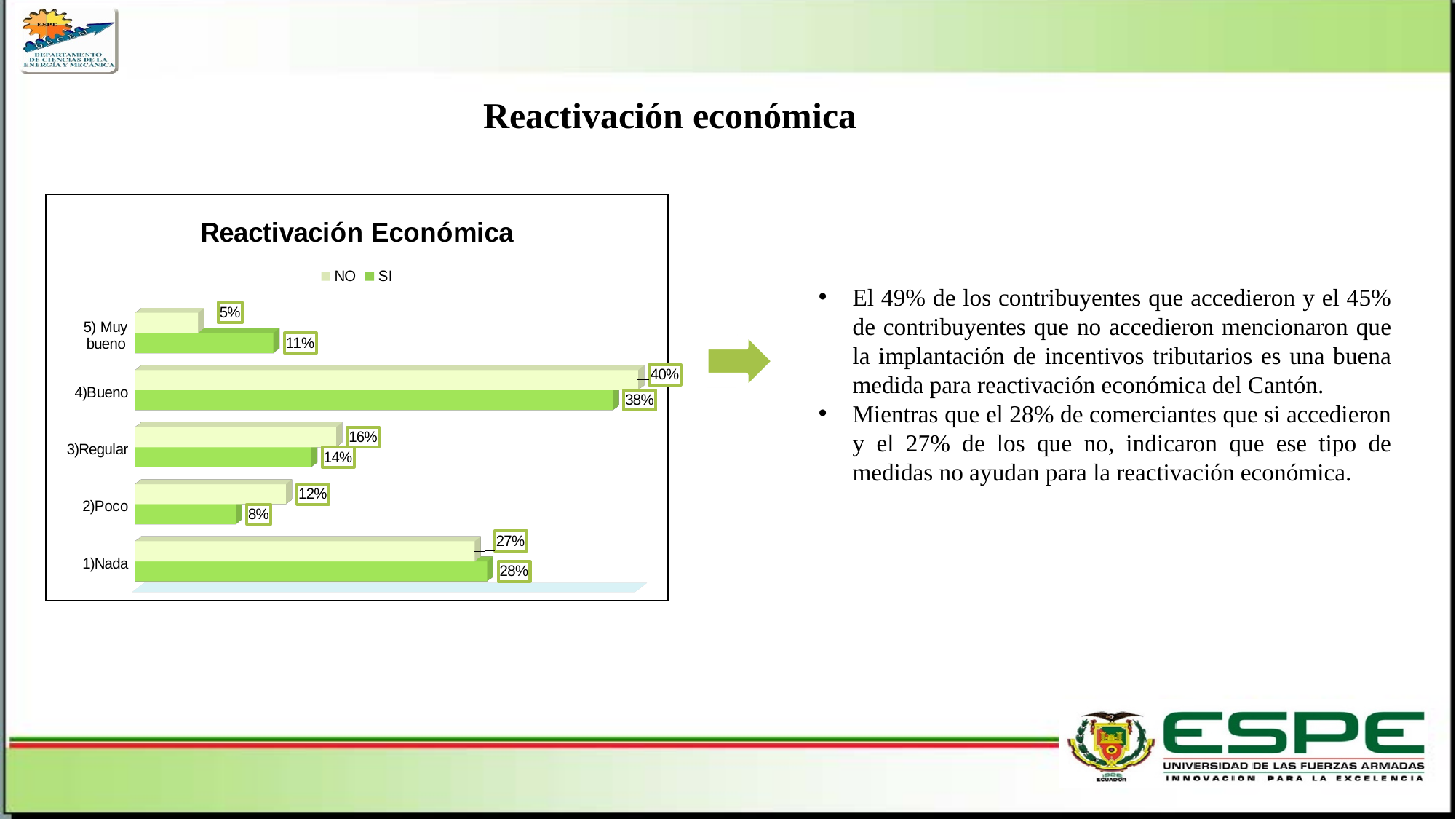
How many categories are shown in the chart? 5 What is the value of the NO series for the category 4)Bueno? 40% How many series does the legend list? 2 Which category has the highest value in the SI series? 4)Bueno What is the value of the SI series for the category 1)Nada? 28% What is the value of the NO series for the category 2)Poco? 12% What is the title of the chart? Reactivación Económica What kind of chart is shown on the slide? Bar chart What is the value of the SI series for the category 5) Muy bueno? 11% What is the difference between the NO and SI values for the category 3)Regular? 2% For the category 2)Poco, which series has the larger value, NO or SI? NO Which category has the lowest value in the NO series? 5) Muy bueno